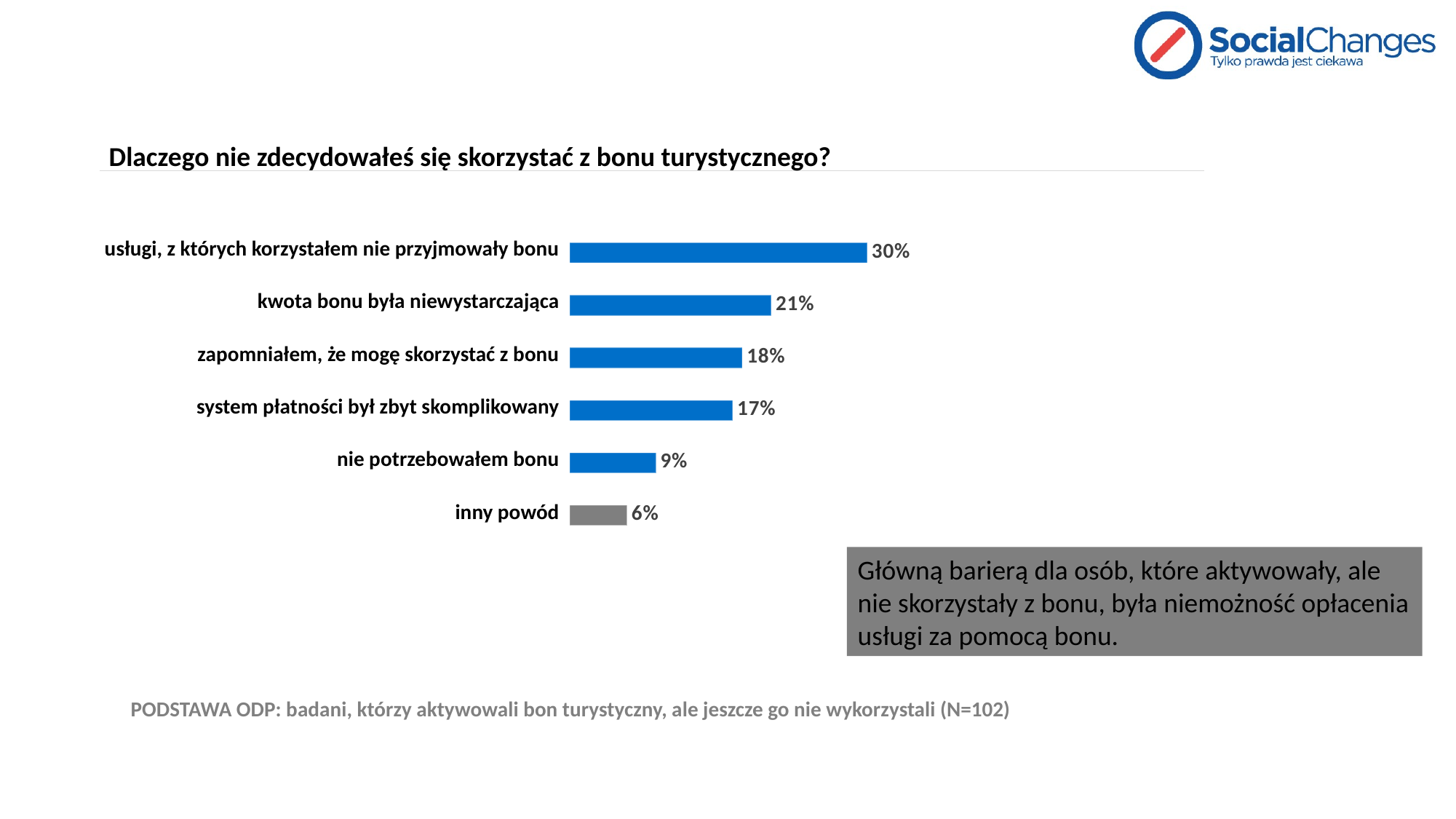
How many categories are shown in the chart? 6 What is the value for "inny powód"? 6% What is the value for "kwota bonu była niewystarczająca"? 21% What is the value for "system płatności był zbyt skomplikowany"? 17% What is the value for "usługi, z których korzystałem nie przyjmowały bonu"? 30% Which category has the highest value? usługi, z których korzystałem nie przyjmowały bonu What kind of chart is shown on the slide? bar chart What is the difference between "zapomniałem, że mogę skorzystać z bonu" and "nie potrzebowałem bonu"? 9% Which category has the lowest value? inny powód Which is larger: "zapomniałem, że mogę skorzystać z bonu" or "nie potrzebowałem bonu"? zapomniałem, że mogę skorzystać z bonu What is the difference between "usługi, z których korzystałem nie przyjmowały bonu" and "kwota bonu była niewystarczająca"? 9% What is the title of the chart? Dlaczego nie zdecydowałeś się skorzystać z bonu turystycznego?